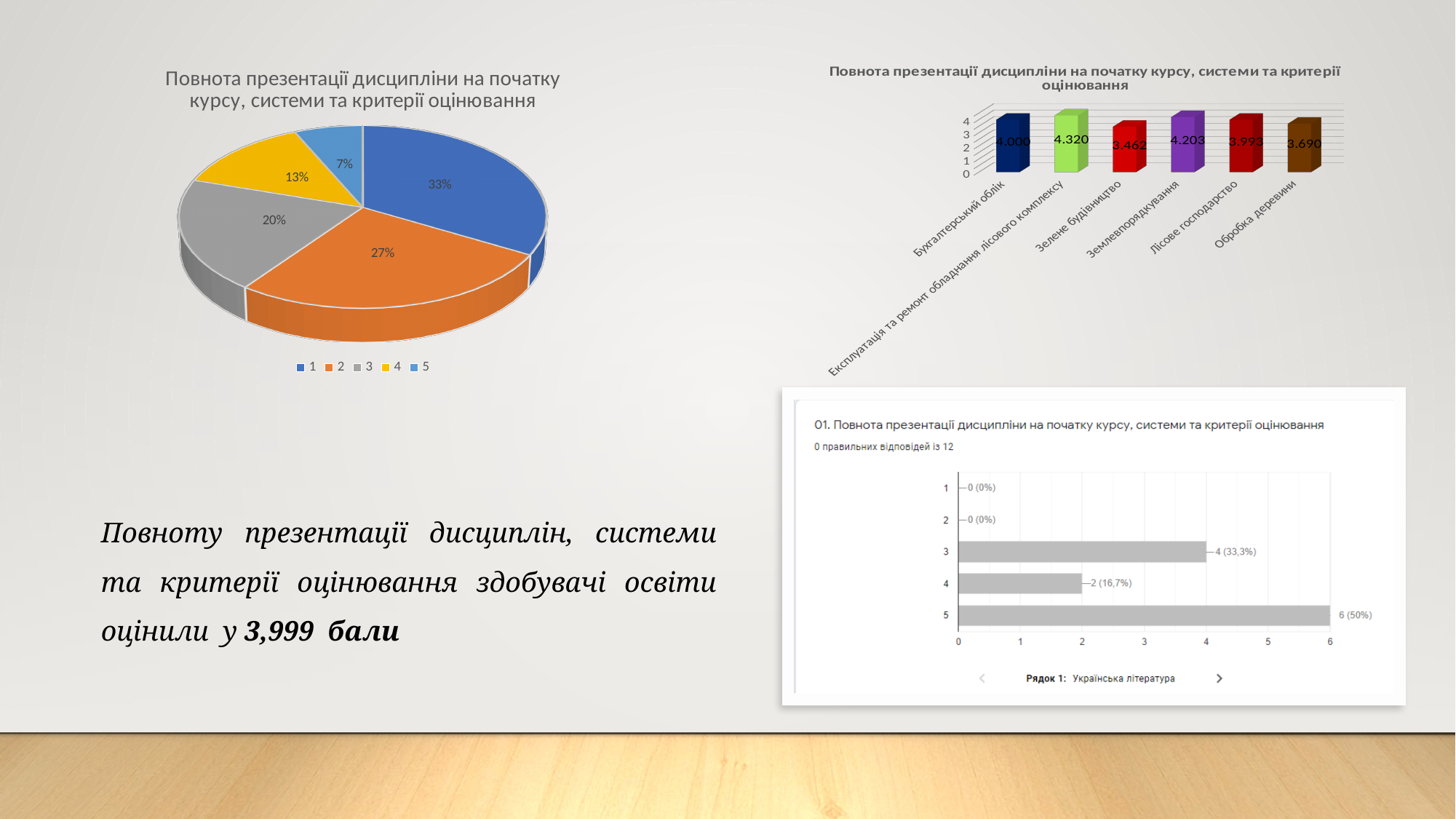
In the bar chart on the top right, which is larger: the value for Землевпорядкування or the value for Лісове господарство? Землевпорядкування In the pie chart on the top left, what share does category 1 have? 33% In the pie chart on the top left, what is the difference between the shares of category 2 and category 4? 14% In the bar chart on the top right, which category has the highest value? Експлуатація та ремонт обладнання лісового комплексу What type of chart is shown on the top left of the slide? Pie chart In the bar chart on the top right, which category has the lowest value? Зелене будівництво In the bar chart on the top right, what is the value for Зелене будівництво? 3.462 In the pie chart on the top left, which category has the smallest slice? 5 In the bar chart on the bottom right, what is the value for rating 5? 6 (50%) In the bar chart on the bottom right, which rating has the longest bar? 5 In the pie chart on the top left, how many categories does the legend list? 5 In the bar chart on the top right, how many categories are plotted? 6